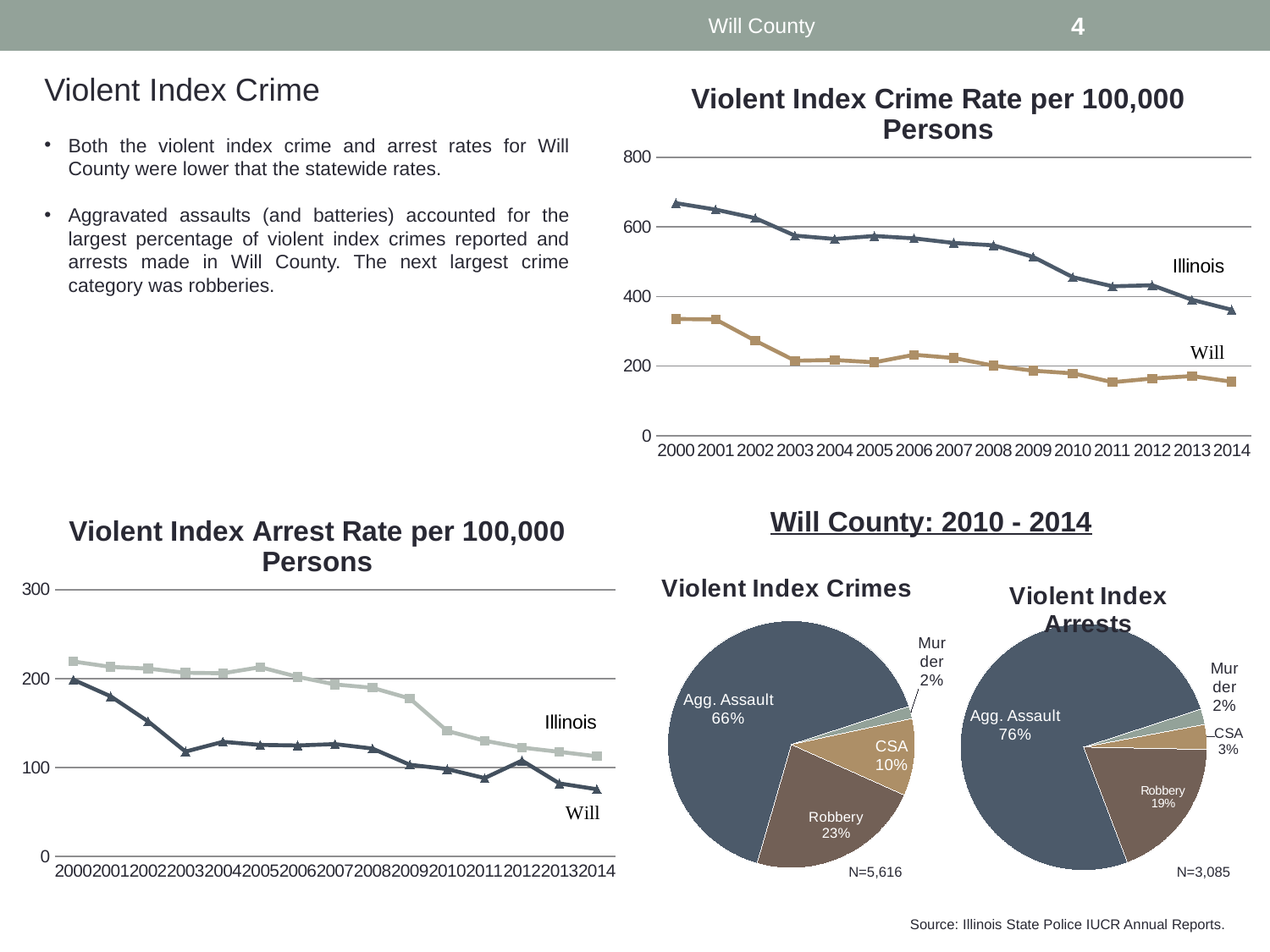
In the 'Violent Index Crimes' pie chart, what is the difference between the Robbery share and the CSA share? 13% What kind of chart is the 'Violent Index Crime Rate per 100,000 Persons' chart? line chart In the 'Violent Index Arrests' pie chart, what share is Agg. Assault? 76% In the 'Violent Index Arrest Rate per 100,000 Persons' chart, is the Will value for 2000 greater or less than 100? greater In the 'Violent Index Arrest Rate per 100,000 Persons' chart, which is larger in 2014, Illinois or Will? Illinois In the 'Violent Index Crime Rate per 100,000 Persons' chart, is the Illinois value for 2000 greater or less than 600? greater In the 'Violent Index Crime Rate per 100,000 Persons' chart, is the Will value for 2014 greater or less than 200? less In the 'Violent Index Crimes' pie chart, which category has the largest slice? Agg. Assault In the 'Violent Index Arrests' pie chart, which category has the smallest slice? Murder How many years are shown on the x axis of the 'Violent Index Crime Rate per 100,000 Persons' chart? 15 In the 'Violent Index Crime Rate per 100,000 Persons' chart, does the Illinois line rise or fall from 2000 to 2014? fall In the 'Violent Index Crimes' pie chart, what share is Robbery? 23%